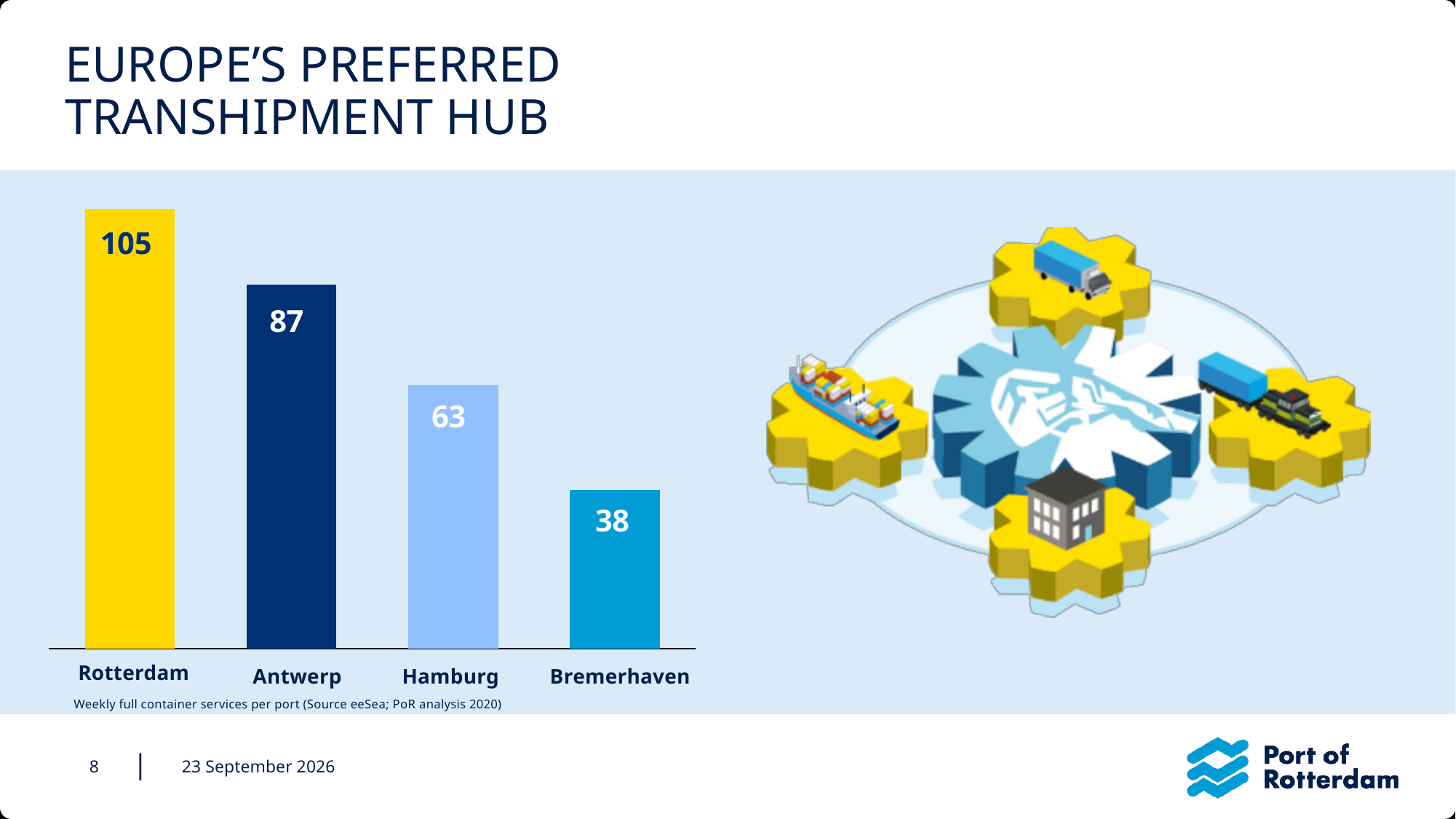
What kind of chart is shown on the slide? Bar chart Which port has the highest value? Rotterdam What is the value for Bremerhaven? 38 Which is larger, the value for Antwerp or the value for Hamburg? Antwerp What is the difference between the values for Rotterdam and Antwerp? 18 Do the values rise or fall from left to right across the chart? Fall What is the value for Rotterdam? 105 What is the value for Antwerp? 87 How many ports are shown in the chart? 4 Which port has the lowest value? Bremerhaven What is the value for Hamburg? 63 What is the difference between the values for Hamburg and Bremerhaven? 25